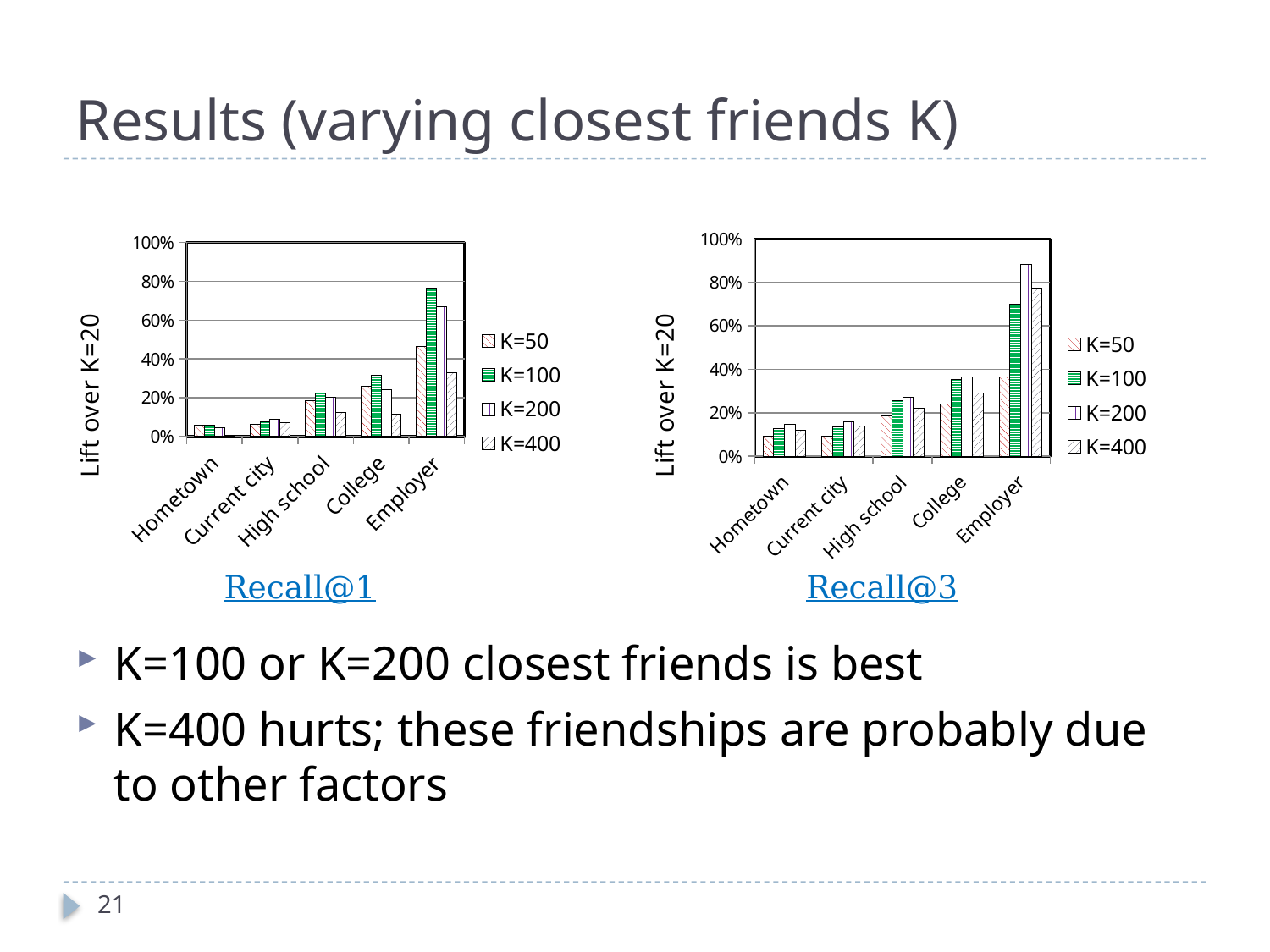
In the Recall@1 chart, is the value for Employer with K=100 greater or less than 60%? greater In the Recall@1 chart, how many series does the legend list? 4 In the Recall@1 chart, is the value for College with K=400 greater or less than 20%? less In the Recall@3 chart, is the value for Employer with K=50 greater or less than 60%? less In the Recall@3 chart, which is larger for Employer: K=200 or K=50? K=200 In the Recall@3 chart, how many categories are shown on the x axis? 5 In the Recall@1 chart, which category has the highest value for K=100? Employer In the Recall@3 chart, which series has the highest value for Employer? K=200 In the Recall@3 chart, do the K=200 values generally rise or fall from Hometown to Employer? rise What is the y-axis label of the Recall@1 chart? Lift over K=20 In the Recall@1 chart, which is larger for Employer: K=100 or K=400? K=100 In the Recall@1 chart, what kind of chart is shown? bar chart